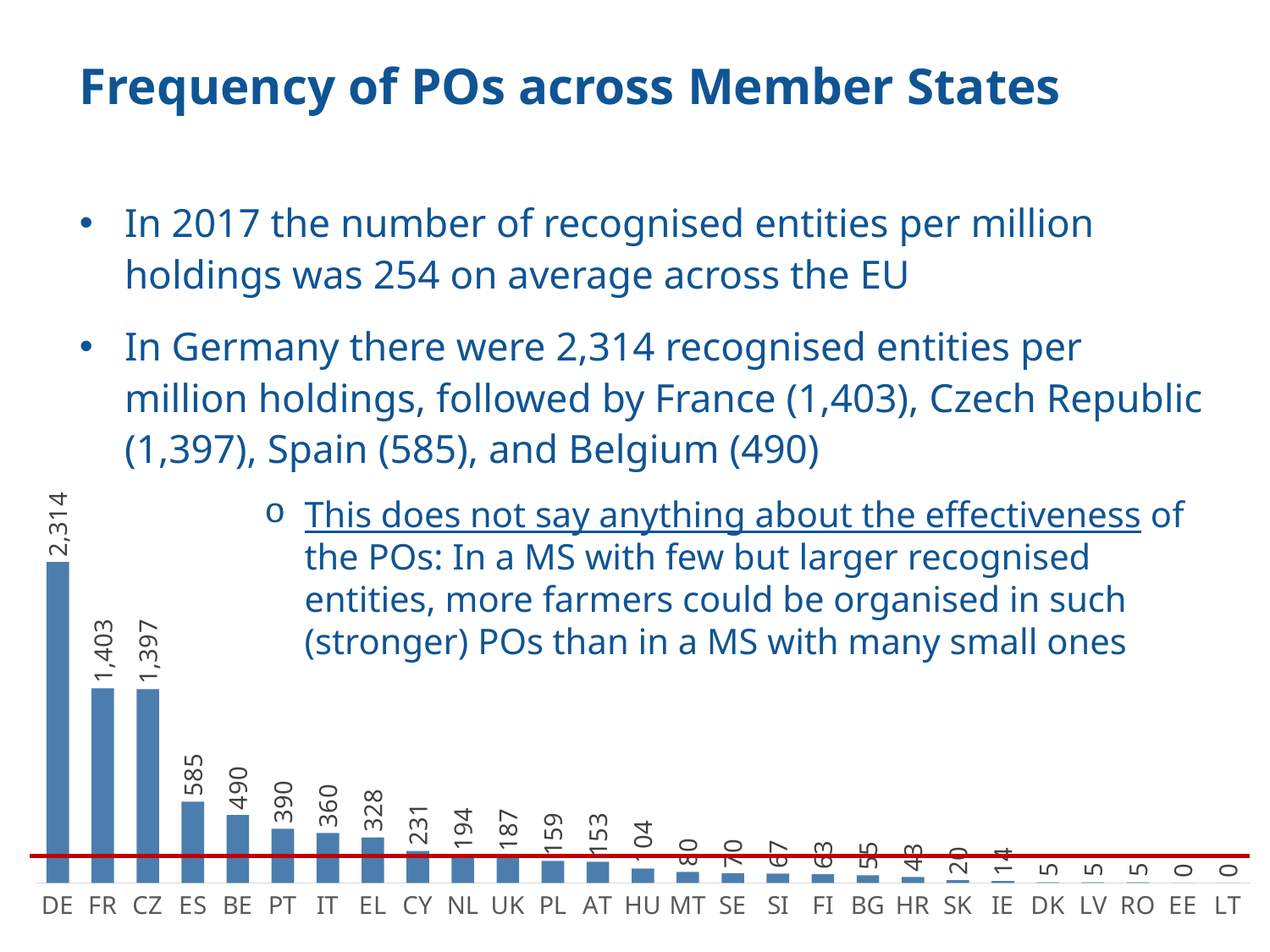
What is the value for PT in the chart? 390 Which Member State has the highest value in the chart? DE Do the values rise or fall moving from left to right along the x axis? Fall What kind of chart is shown on the slide? Bar chart How many Member States are shown on the x axis of the chart? 27 What is the value for ES in the chart? 585 Which has a larger value, PT or IT? PT What is the difference between the values for FR and CZ? 6 What is the value for DE in the chart? 2,314 What is the value for SK in the chart? 20 What is the difference between the values for ES and BE? 95 Which Member States have a value of 0 in the chart? EE and LT